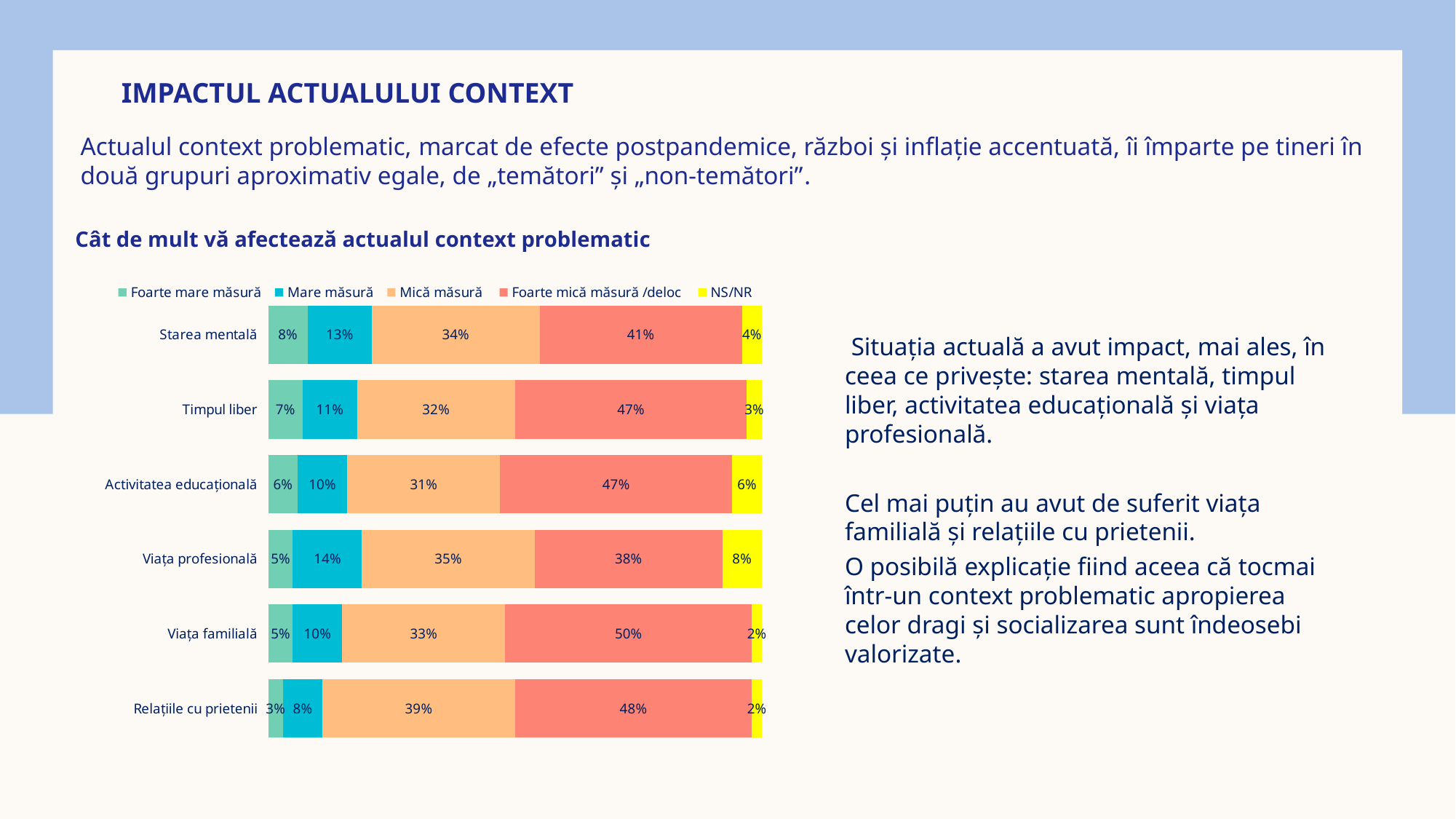
How many series does the legend list? 5 What percentage of respondents said the current context affects their mental state (Starea mentală) to a very large extent (Foarte mare măsură)? 8% Which is larger: the 'Mică măsură' value for Viața profesională or for Timpul liber? Viața profesională What kind of chart is shown on the slide? Stacked bar chart Which category has the lowest 'Foarte mare măsură' value? Relațiile cu prietenii What is the NS/NR value for Viața profesională? 8% What is the difference between the 'Foarte mică măsură /deloc' values for Viața familială and Starea mentală? 9 percentage points Which category has the highest 'Mare măsură' value? Viața profesională Which category has the highest 'Foarte mare măsură' value? Starea mentală What is the 'Foarte mică măsură /deloc' value for Viața familială? 50% How many categories are shown on the chart? 6 What is the 'Mică măsură' value for Relațiile cu prietenii? 39%